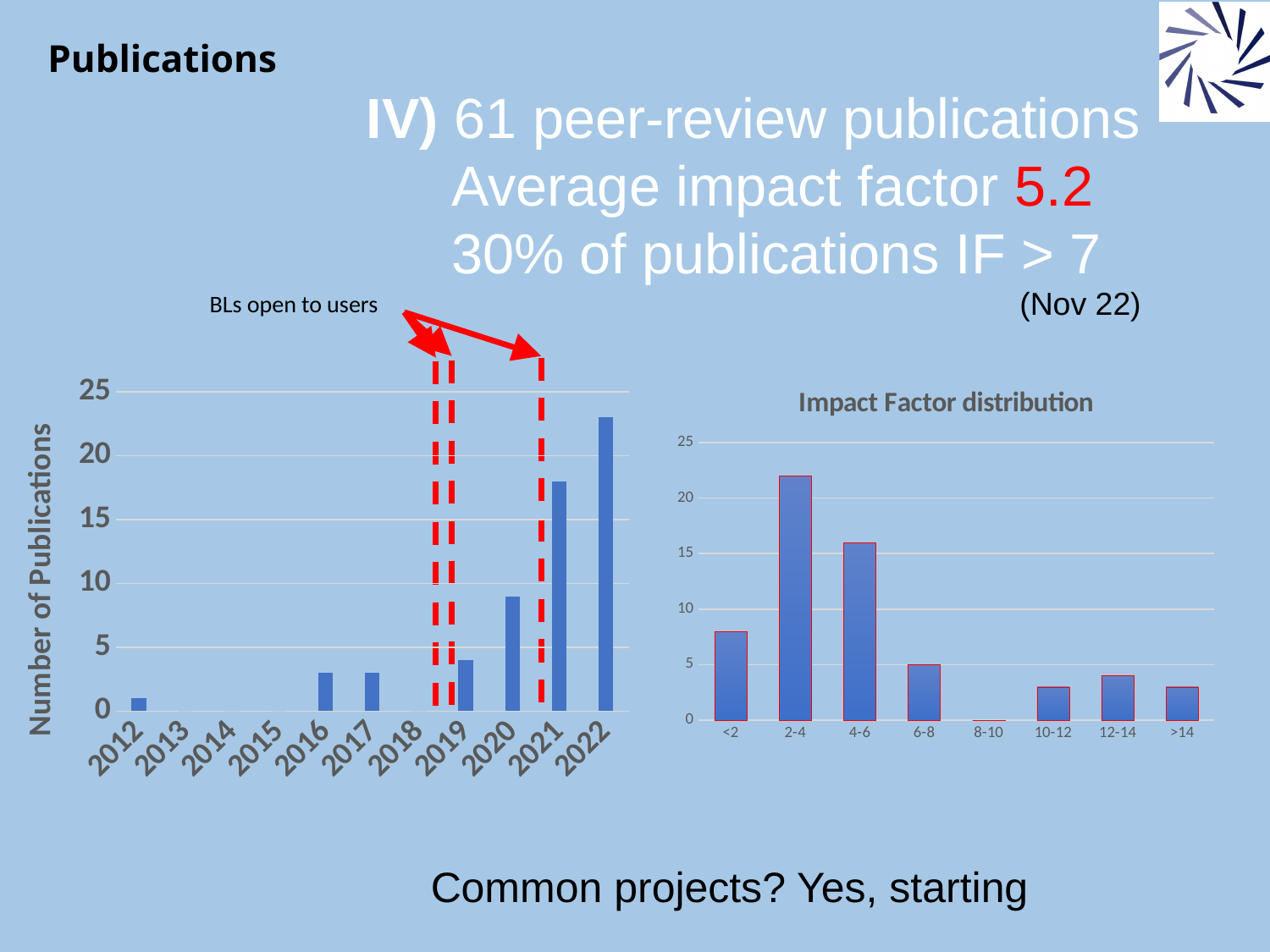
What is the title of the right chart? Impact Factor distribution In the Impact Factor distribution chart, which is larger, the value for 4-6 or the value for 6-8? 4-6 In the left chart (Number of Publications), is the value for 2020 greater or less than 10? less In the Impact Factor distribution chart, how many impact factor ranges are shown on the x axis? 8 In the Impact Factor distribution chart, is the value for 2-4 greater or less than 20? greater In the Impact Factor distribution chart, which impact factor range has the highest number of publications? 2-4 What type of chart is the left chart showing Number of Publications by year? bar chart In the left chart (Number of Publications), how many years are shown on the x axis? 11 In the left chart (Number of Publications), which is larger, the value for 2020 or the value for 2021? 2021 In the left chart (Number of Publications), which year has the highest number of publications? 2022 In the left chart (Number of Publications), is the value for 2022 greater or less than 20? greater In the left chart (Number of Publications), do the values generally rise or fall from 2016 to 2022? rise